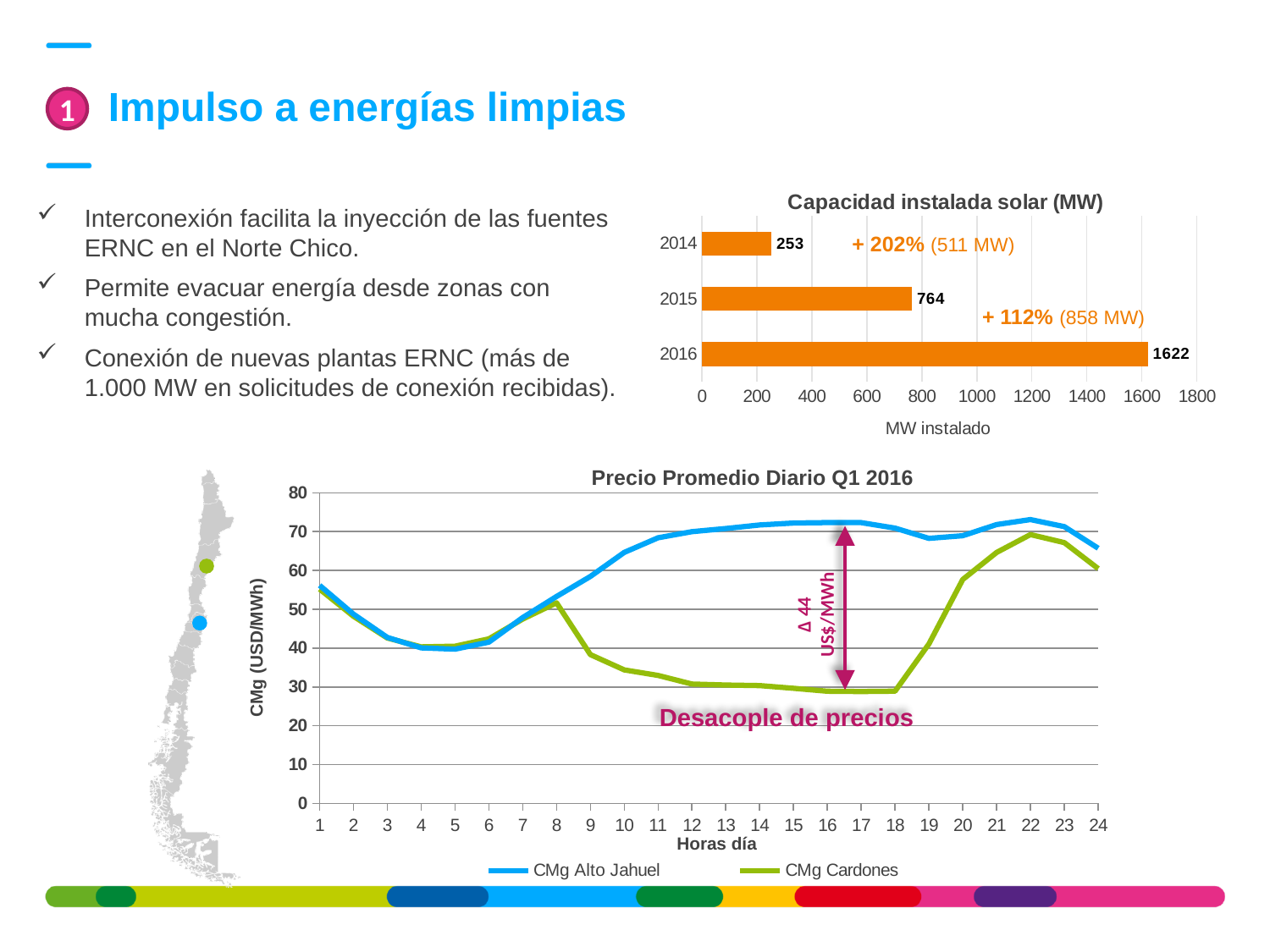
In the 'Precio Promedio Diario Q1 2016' chart, is the value of CMg Cardones at hour 16 greater or less than 40? less In the 'Capacidad instalada solar (MW)' chart, how many years are shown? 3 In the 'Capacidad instalada solar (MW)' chart, what is the difference between the 2016 and 2015 values? 858 In the 'Capacidad instalada solar (MW)' chart, what percentage increase is shown between 2015 and 2016? + 112% What type of chart is 'Capacidad instalada solar (MW)'? bar chart In the 'Precio Promedio Diario Q1 2016' chart, what is the label on the y axis? CMg (USD/MWh) In the 'Capacidad instalada solar (MW)' chart, what is the difference between the 2015 and 2014 values? 511 In the 'Precio Promedio Diario Q1 2016' chart, how many series does the legend list? 2 In the 'Capacidad instalada solar (MW)' chart, what is the value for 2015? 764 In the 'Precio Promedio Diario Q1 2016' chart, which series is higher at hour 14, CMg Alto Jahuel or CMg Cardones? CMg Alto Jahuel In the 'Capacidad instalada solar (MW)' chart, which year has the lowest installed capacity? 2014 In the 'Capacidad instalada solar (MW)' chart, what is the value for 2016? 1622